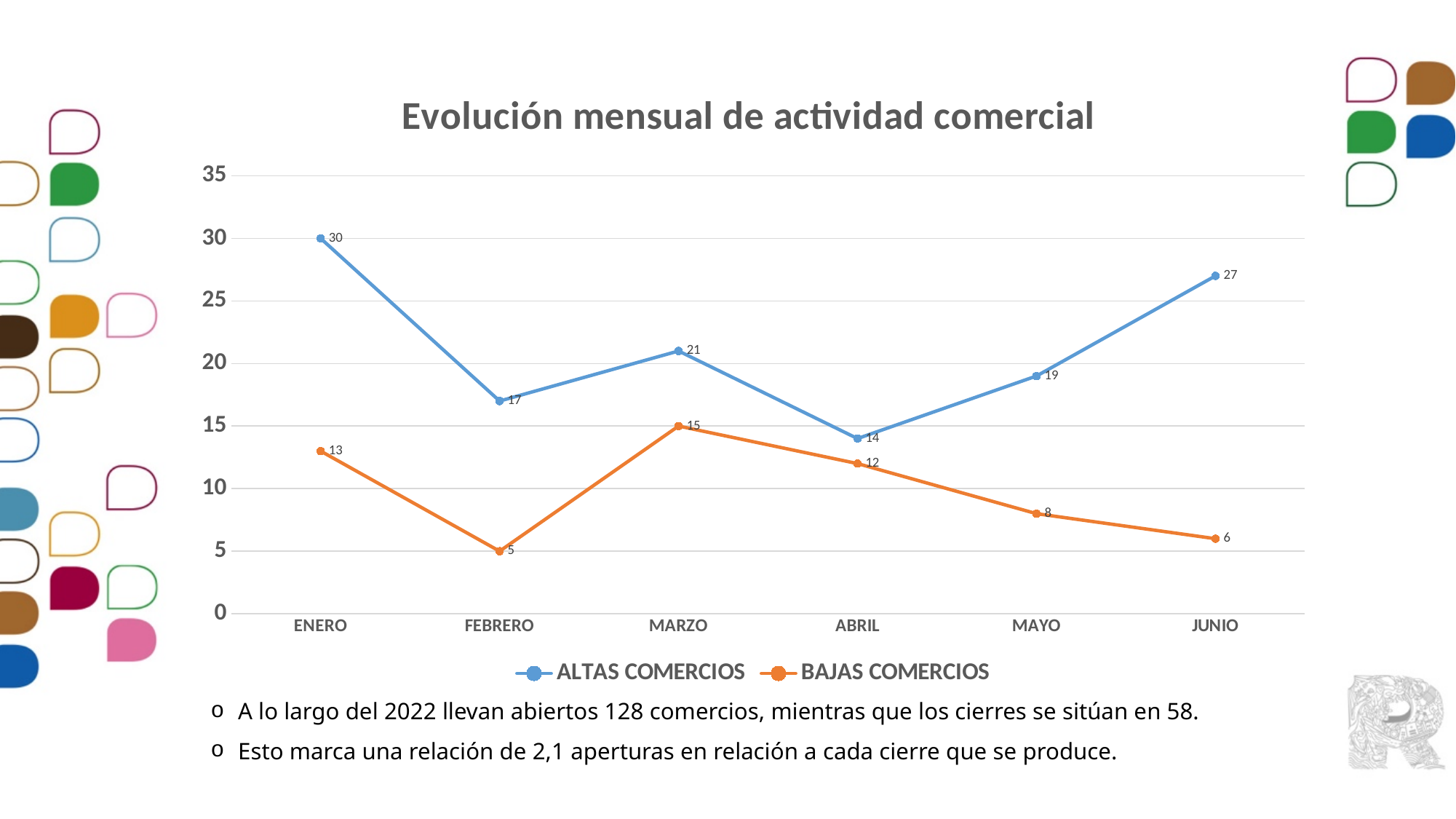
What kind of chart is shown? line chart What is the value for ALTAS COMERCIOS in JUNIO? 27 In which month is ALTAS COMERCIOS highest? ENERO What is the difference between ALTAS COMERCIOS and BAJAS COMERCIOS in ABRIL? 2 How many series does the legend list? 2 What is the value for BAJAS COMERCIOS in MARZO? 15 Which is larger in MAYO, ALTAS COMERCIOS or BAJAS COMERCIOS? ALTAS COMERCIOS What is the value for ALTAS COMERCIOS in ENERO? 30 How many months are shown on the x axis? 6 What is the title of the chart? Evolución mensual de actividad comercial In which month is BAJAS COMERCIOS lowest? FEBRERO Does BAJAS COMERCIOS rise or fall from MARZO to JUNIO? fall